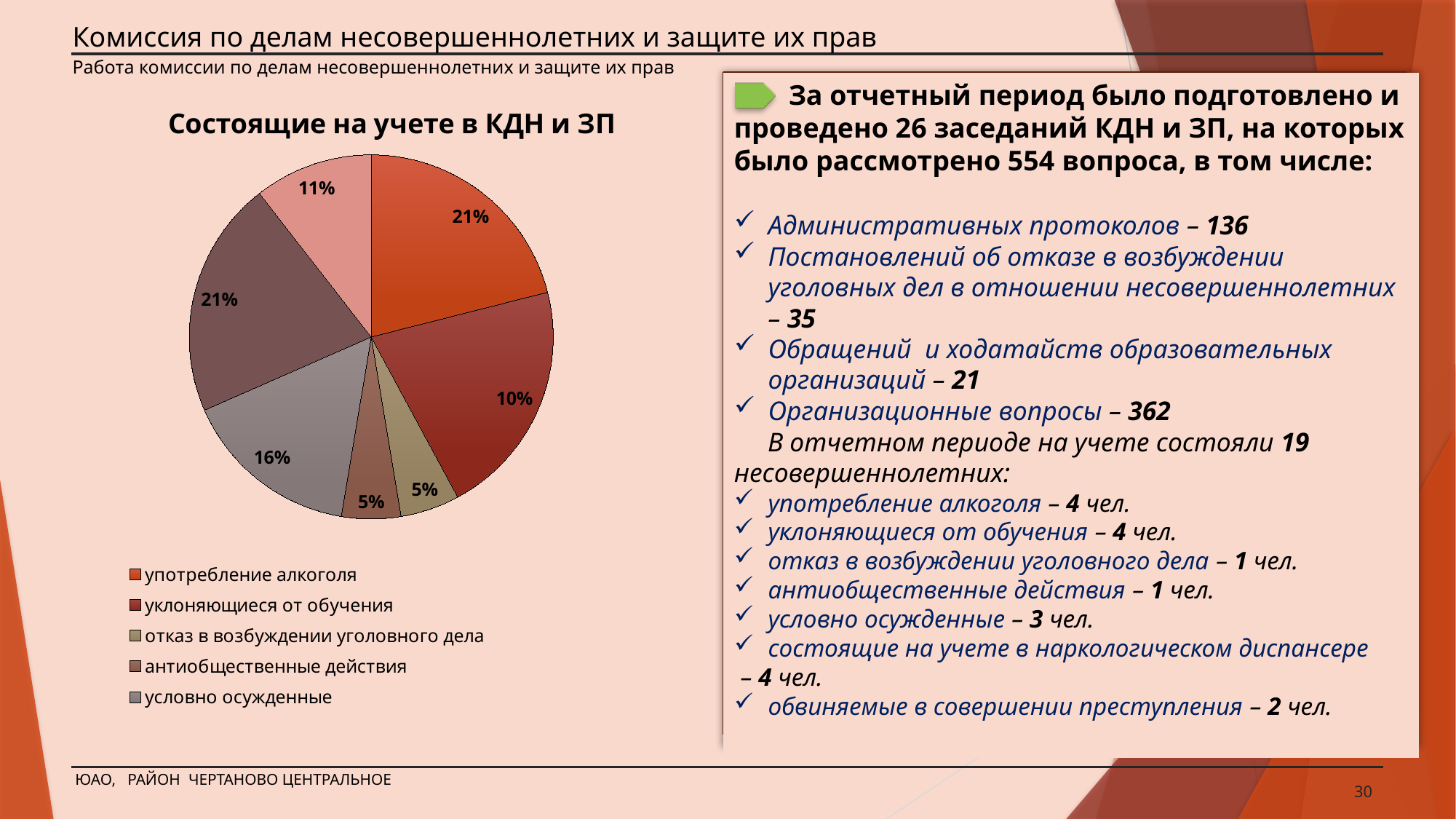
Which slice is larger: 'употребление алкоголя' or 'условно осужденные'? употребление алкоголя What is the difference in percentage points between the 'употребление алкоголя' slice and the 'условно осужденные' slice? 5 percentage points How many slices does the pie chart have? 7 What colour is the 'употребление алкоголя' slice in the pie chart? Orange-red What percentage is shown for the slice 'употребление алкоголя'? 21% What percentage is shown for the slice 'антиобщественные действия'? 5% How many entries does the chart legend list? 5 What percentage is shown for the slice 'условно осужденные'? 16% What kind of chart is shown on the slide? Pie chart What is the title of the pie chart? Состоящие на учете в КДН и ЗП What percentage is shown for the slice 'отказ в возбуждении уголовного дела'? 5% What percentage label is printed on the slice 'уклоняющиеся от обучения'? 10%